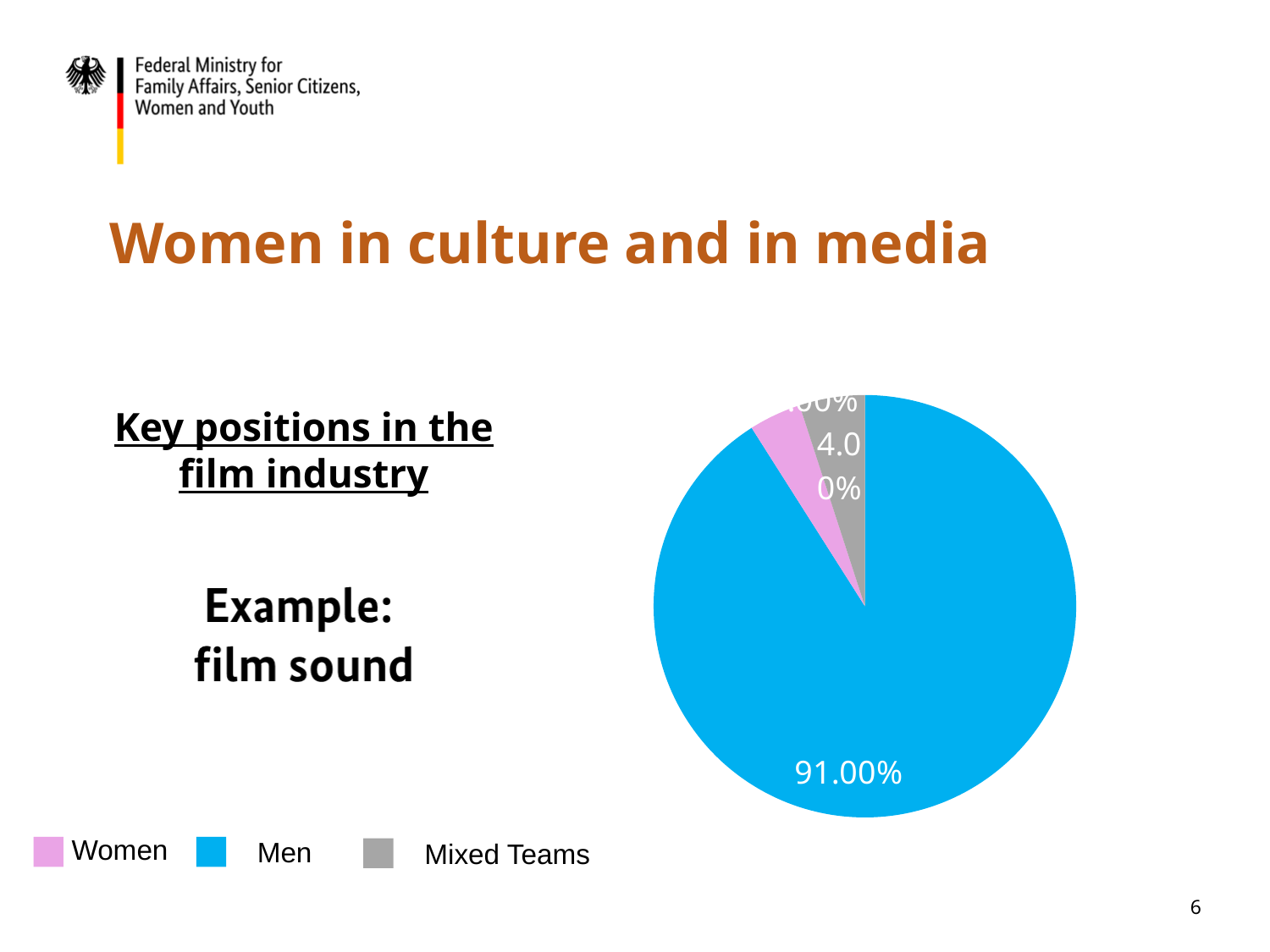
What colour represents Men in the pie chart? blue How many categories does the legend list? 3 What kind of chart is shown on the slide? pie chart Which is larger, the slice for Men or the slice for Women? Men What percentage of film sound key positions is held by Men? 91.00% Which category has the largest slice of the pie? Men Which is larger, the slice for Men or the slice for Mixed Teams? Men What share of the pie does the Men slice represent? 91.00% What are the three legend entries of the pie chart? Women, Men, Mixed Teams